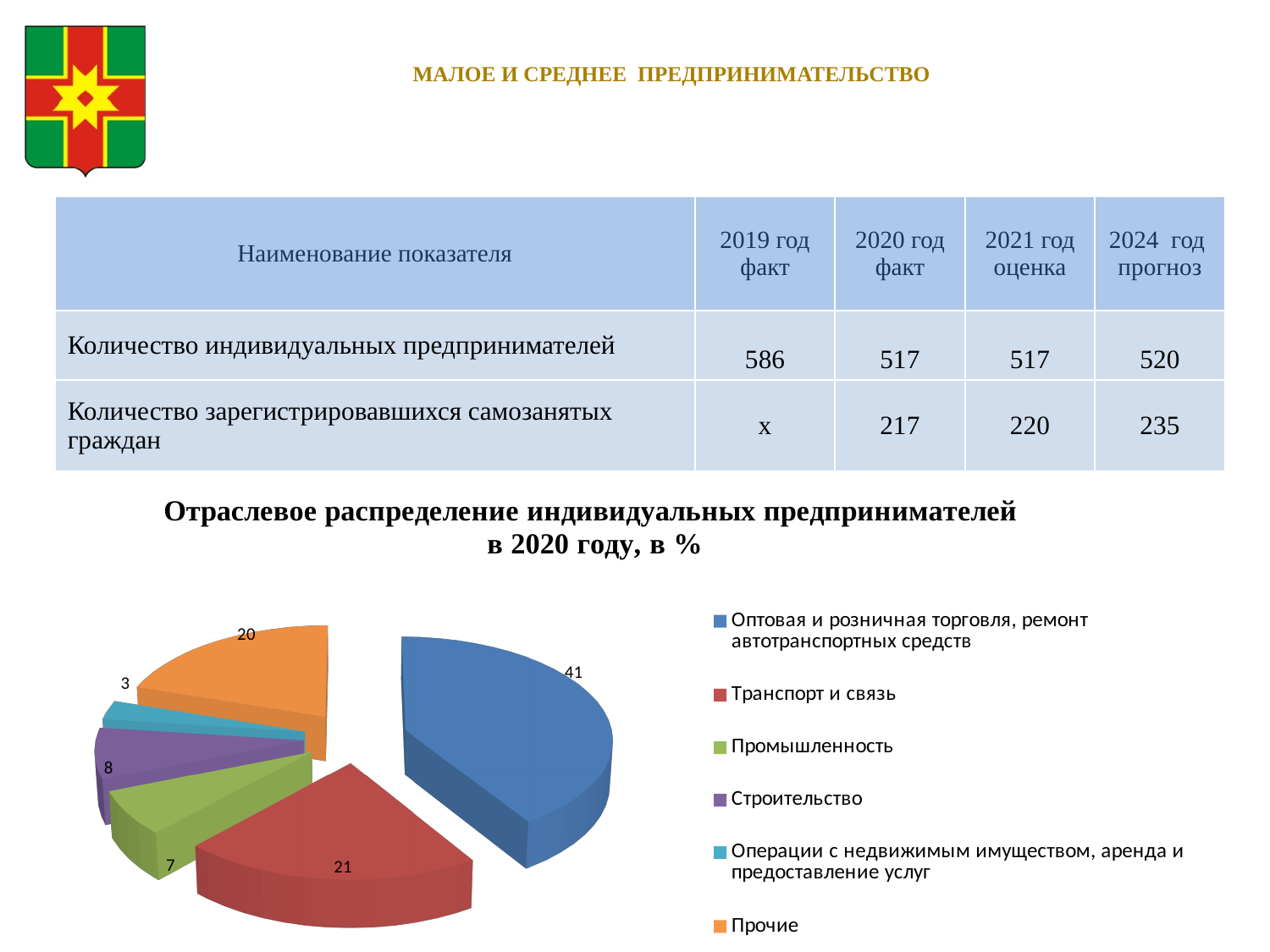
What type of chart is shown on the slide? pie chart What is the value for Операции с недвижимым имуществом, аренда и предоставление услуг in the pie chart? 3 What is the value for Прочие in the pie chart? 20 What is the value for Строительство in the pie chart? 8 How many categories does the pie chart legend list? 6 What is the difference between the values for Оптовая и розничная торговля, ремонт автотранспортных средств and Транспорт и связь in the pie chart? 20 Which is larger in the pie chart: Строительство or Промышленность? Строительство What is the value for Промышленность in the pie chart? 7 What is the value for Транспорт и связь in the pie chart? 21 Which category has the smallest slice in the pie chart? Операции с недвижимым имуществом, аренда и предоставление услуг Which category has the largest slice in the pie chart? Оптовая и розничная торговля, ремонт автотранспортных средств What is the value for Оптовая и розничная торговля, ремонт автотранспортных средств in the pie chart? 41